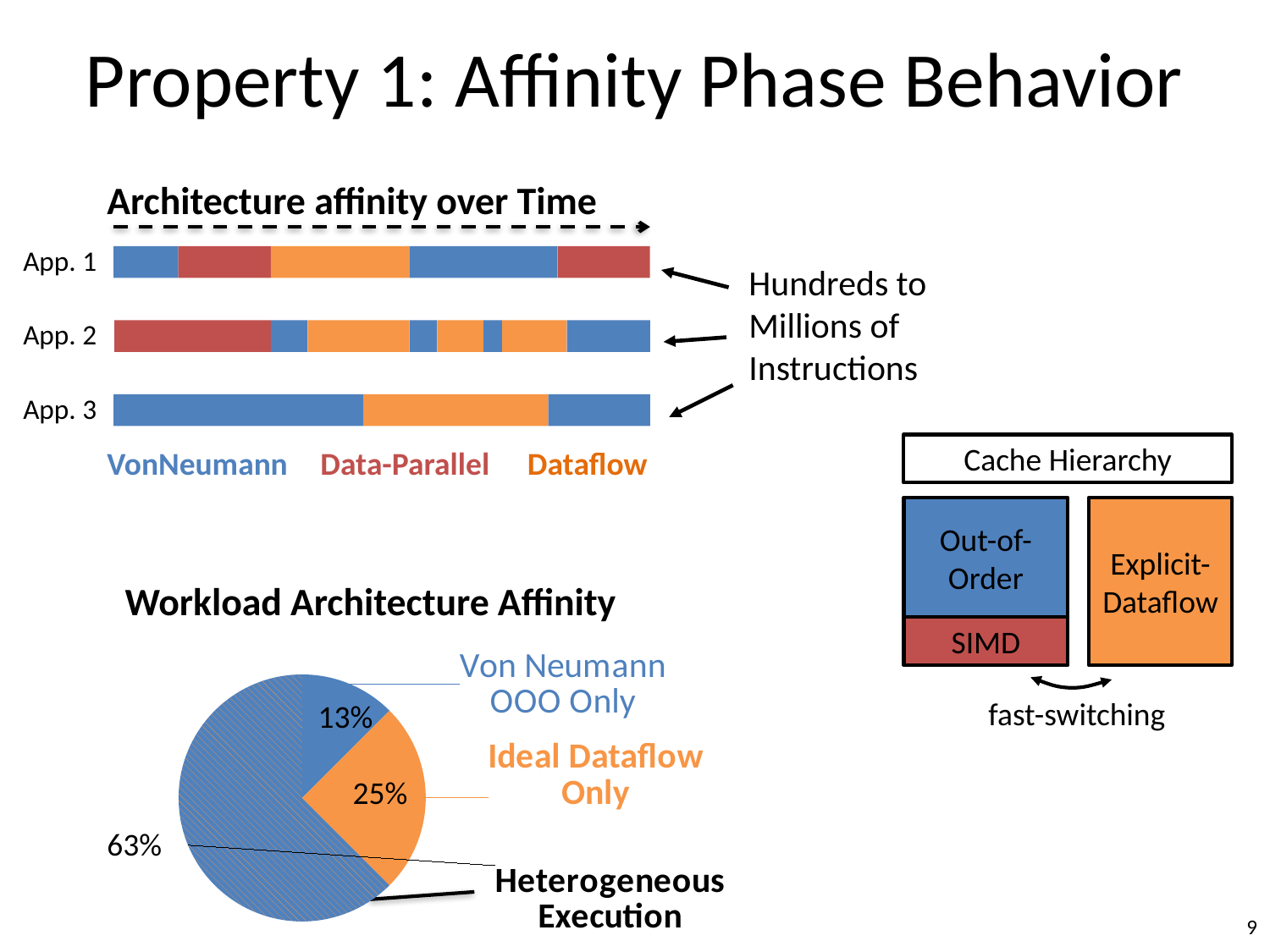
In the Workload Architecture Affinity pie chart, which category has the smallest slice? Von Neumann OOO Only In the Workload Architecture Affinity pie chart, which is larger: Ideal Dataflow Only or Von Neumann OOO Only? Ideal Dataflow Only In the Workload Architecture Affinity pie chart, what percentage is shown for Von Neumann OOO Only? 13% In the Workload Architecture Affinity pie chart, what is the difference in percentage points between Heterogeneous Execution and Ideal Dataflow Only? 38 In the Workload Architecture Affinity pie chart, what share of the pie does Heterogeneous Execution take? 63% How many slices does the Workload Architecture Affinity pie chart have? 3 In the Workload Architecture Affinity pie chart, which category has the largest slice? Heterogeneous Execution In the Workload Architecture Affinity pie chart, what percentage is shown for Ideal Dataflow Only? 25% In the Workload Architecture Affinity pie chart, what is the difference in percentage points between Ideal Dataflow Only and Von Neumann OOO Only? 12 In the Workload Architecture Affinity pie chart, what percentage is shown for Heterogeneous Execution? 63% What kind of chart is the Workload Architecture Affinity chart? Pie chart What is the title of the pie chart on the slide? Workload Architecture Affinity